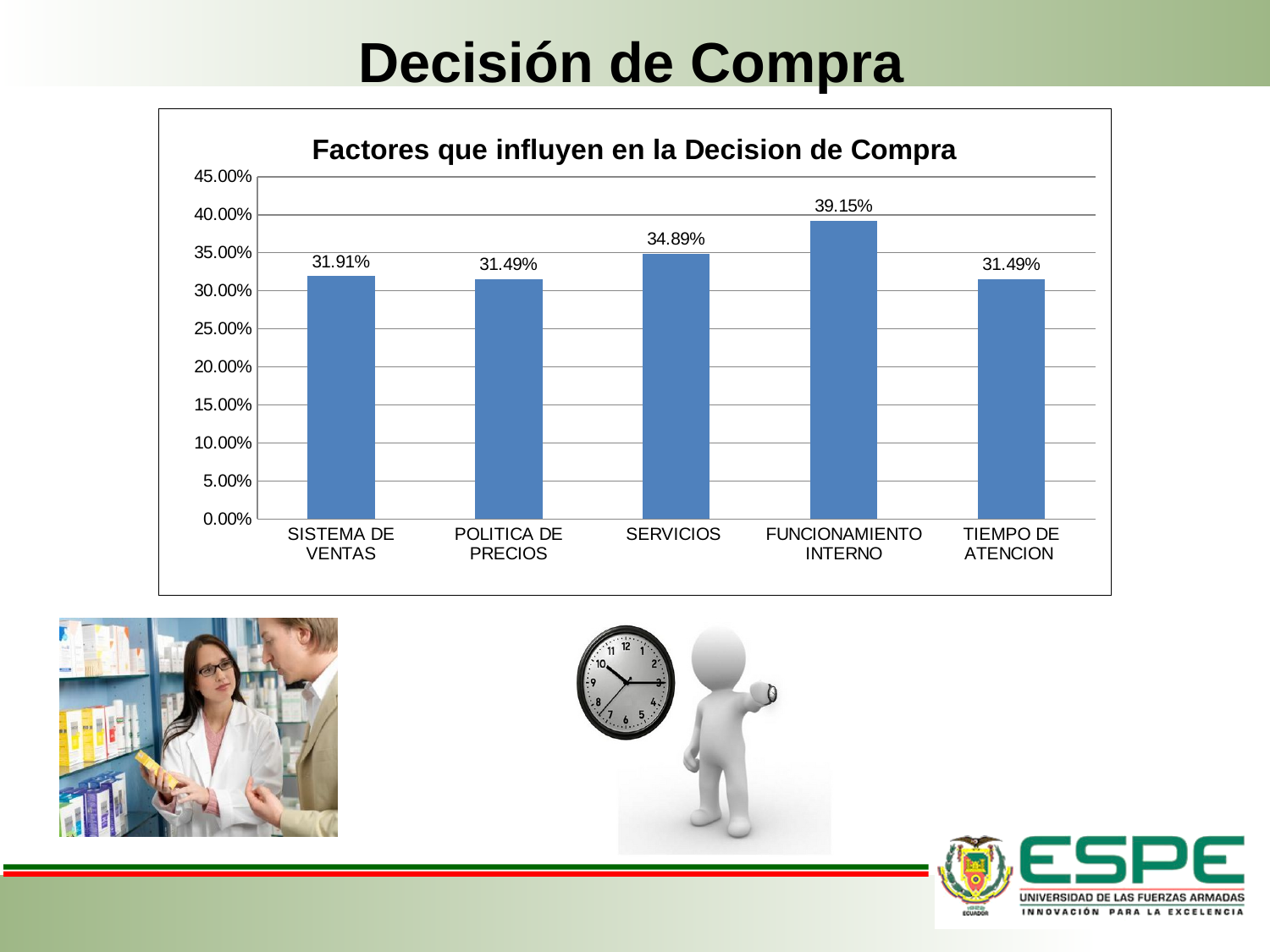
What is the value for FUNCIONAMIENTO INTERNO? 39.15% What kind of chart is shown? bar chart What is the title of the chart? Factores que influyen en la Decision de Compra What is the value for SERVICIOS? 34.89% Which category has the highest value? FUNCIONAMIENTO INTERNO Which is larger, SERVICIOS or SISTEMA DE VENTAS? SERVICIOS What is the difference between SISTEMA DE VENTAS and TIEMPO DE ATENCION? 0.42% What is the difference between FUNCIONAMIENTO INTERNO and SERVICIOS? 4.26% How many categories are shown on the x axis? 5 What is the value for POLITICA DE PRECIOS? 31.49% Is the value for FUNCIONAMIENTO INTERNO greater or less than 35.00%? greater What is the value for SISTEMA DE VENTAS? 31.91%